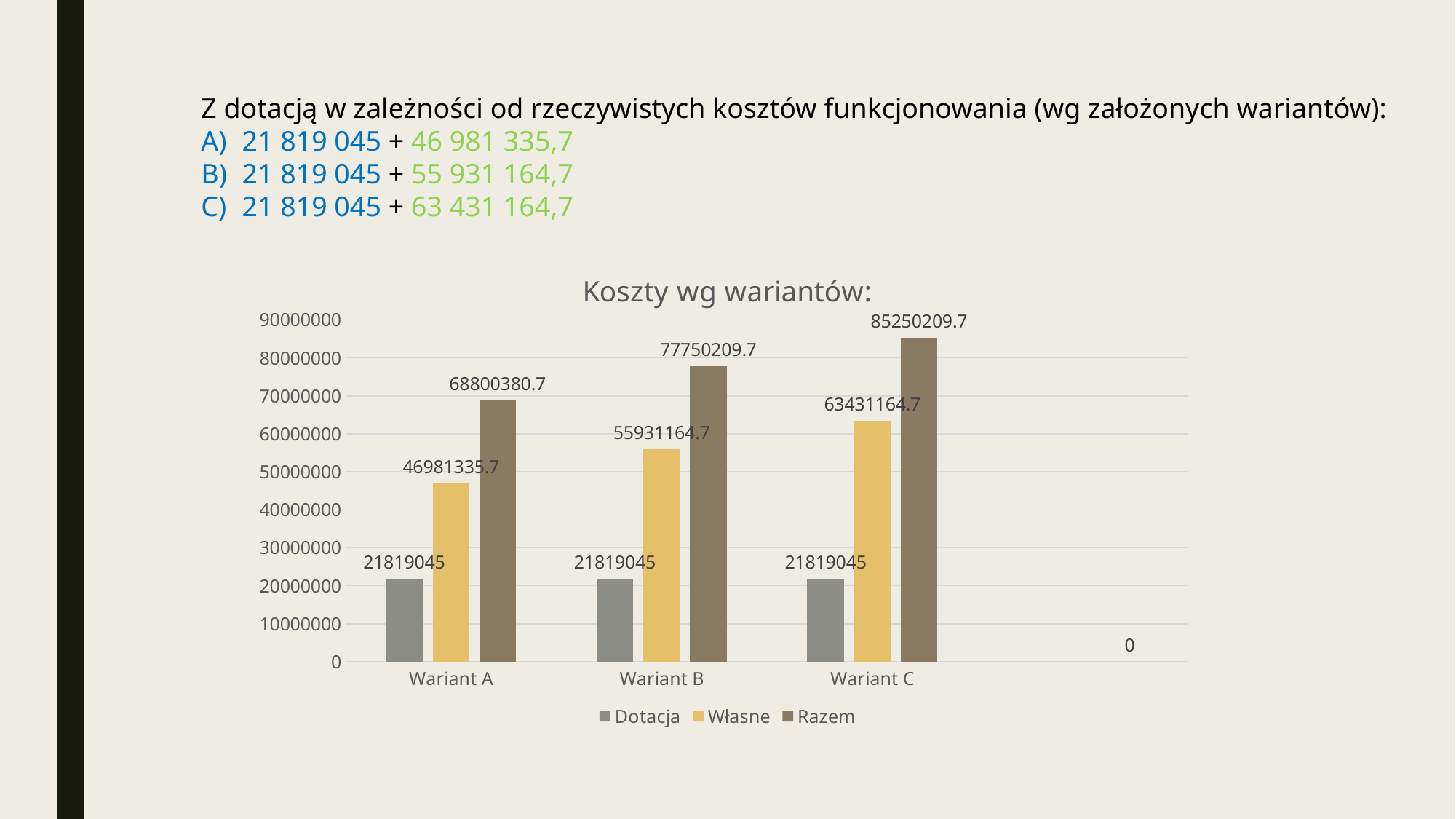
Which variant has the highest Razem value? Wariant C Is the Razem value for Wariant C greater or less than 80000000? greater What is the value of Własne for Wariant A? 46981335.7 How many series does the legend list? 3 What is the difference between the Własne values of Wariant B and Wariant A? 8949829 Which is larger: Własne for Wariant C or Razem for Wariant A? Razem for Wariant A What kind of chart is shown on the slide? bar chart What is the difference between the Razem values of Wariant C and Wariant B? 7500000 What is the value of Razem for Wariant B in the chart "Koszty wg wariantów:"? 77750209.7 What is the value of Dotacja for Wariant C? 21819045 Do the Razem values rise or fall from Wariant A to Wariant C? rise Which variant has the lowest Własne value? Wariant A